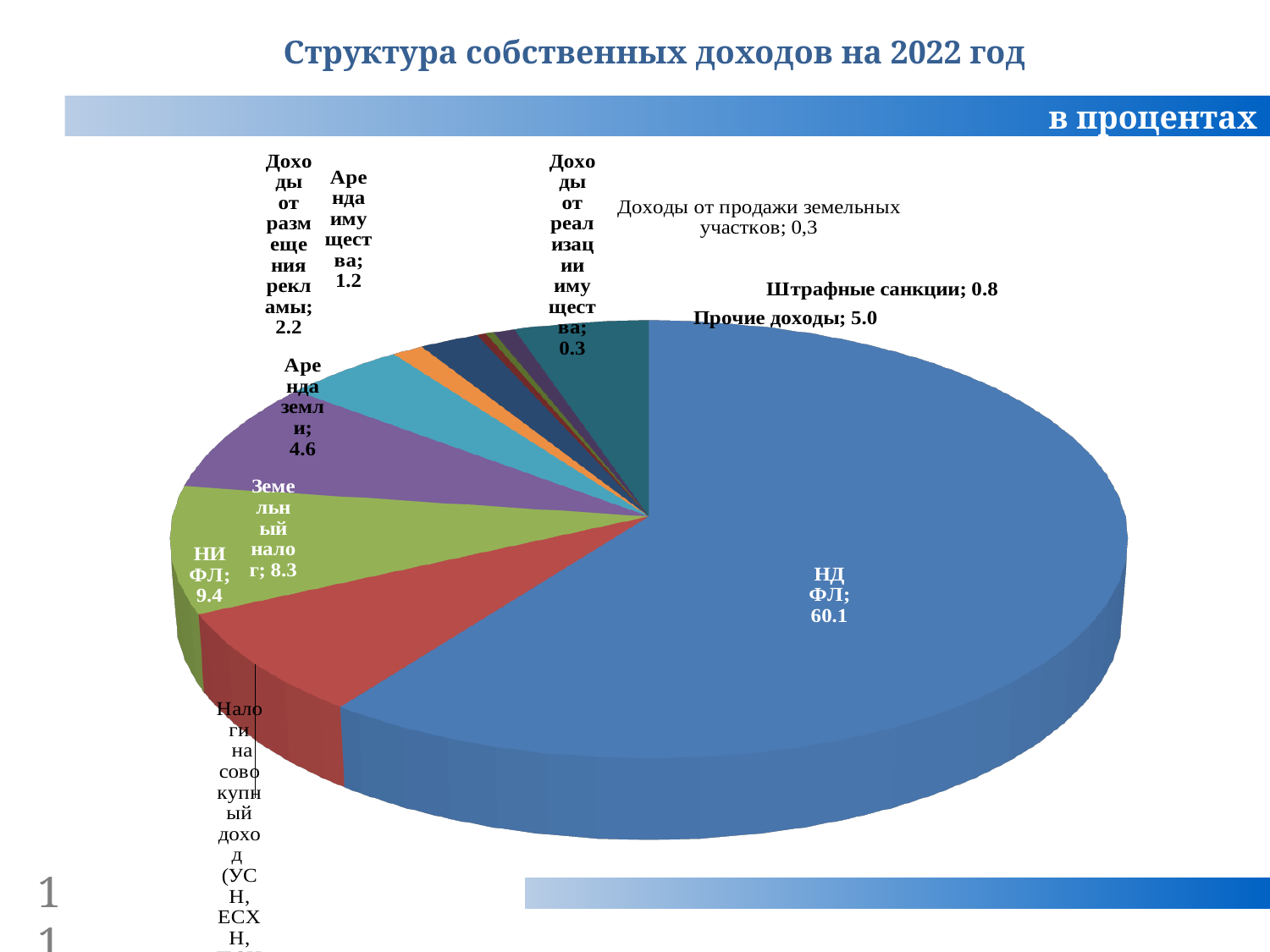
What kind of chart is shown on the slide? pie chart What is the value shown for Прочие доходы? 5.0 What is the difference between the values for НИФЛ and Земельный налог? 1.1 What is the value shown for Доходы от размещения рекламы? 2.2 What is the value shown for НДФЛ? 60.1 Which category has the largest slice of the pie? НДФЛ What is the title of the chart? Структура собственных доходов на 2022 год What is the value shown for Штрафные санкции? 0.8 What is the value shown for Аренда земли? 4.6 What is the value shown for НИФЛ? 9.4 Which is larger, НИФЛ or Земельный налог? НИФЛ What is the value shown for Земельный налог? 8.3